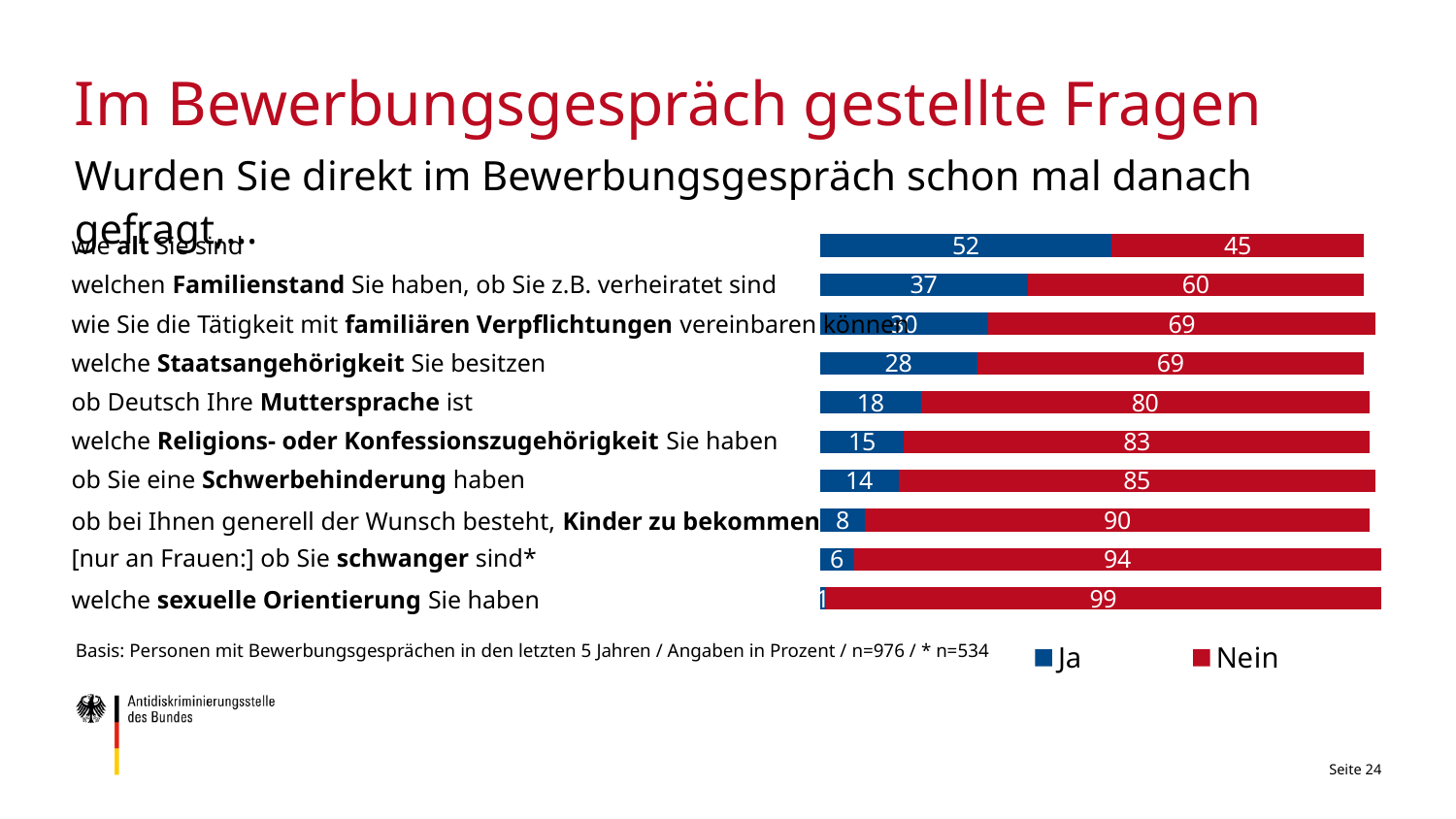
What is the difference between the "Nein" values for Kinder zu bekommen and Staatsangehörigkeit? 21 What kind of chart is shown on the slide? stacked bar chart Which category has the lowest "Ja" value? welche sexuelle Orientierung Sie haben What is the "Ja" value for the question about Schwerbehinderung? 14 How many categories (questions) are shown in the chart? 10 What is the total of the stacked bar for the question about schwanger? 100 Which has a larger "Ja" value: Religions- oder Konfessionszugehörigkeit or Muttersprache? Muttersprache What percentage answered "Ja" to being asked about their Familienstand? 37 What is the "Nein" value for the question about Muttersprache? 80 What is the "Nein" value for the question about sexuelle Orientierung? 99 Which category has the highest "Ja" value? wie alt Sie sind How many series does the legend list? 2